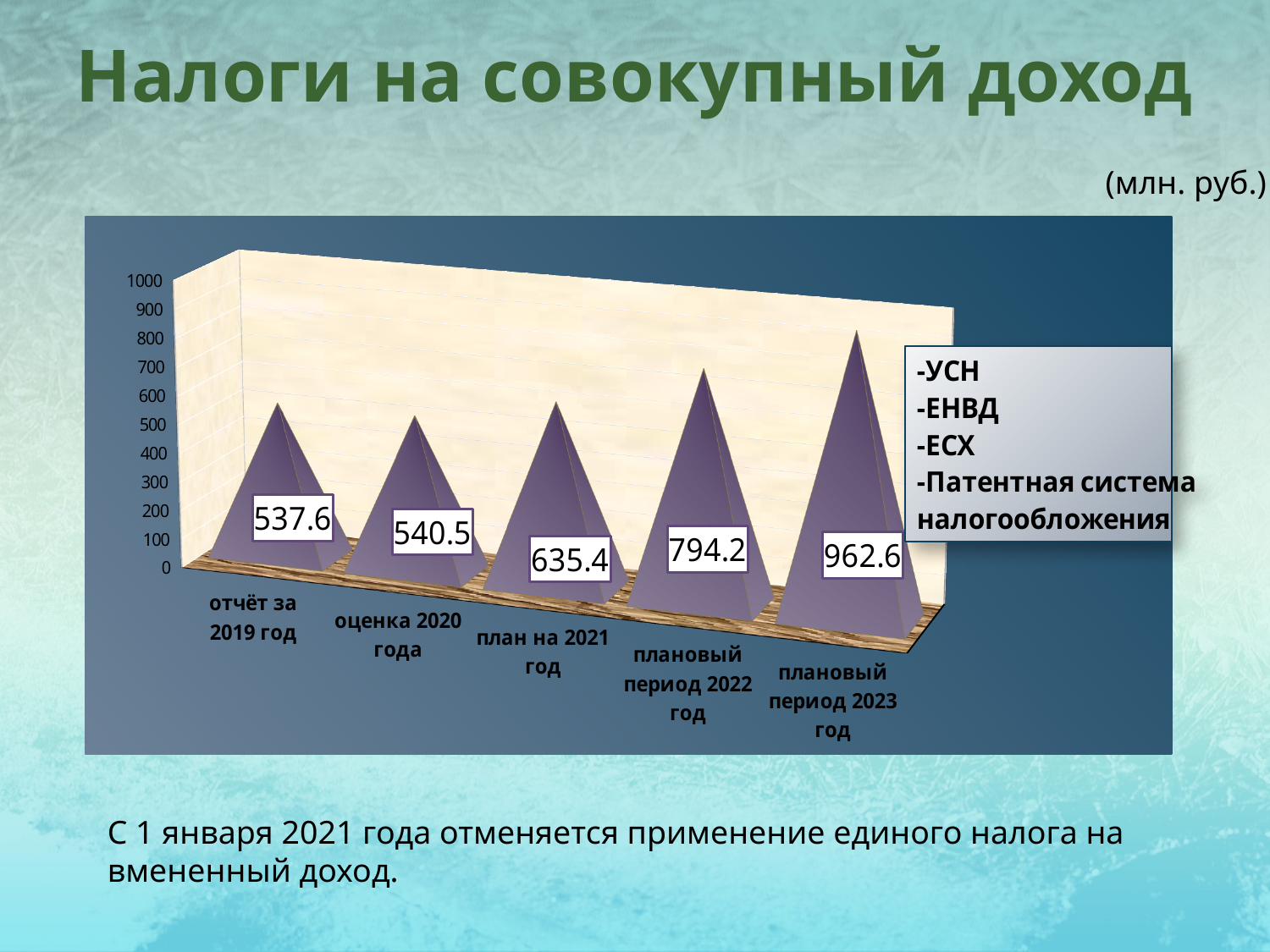
What is the title of the slide containing the chart? Налоги на совокупный доход Which category has the highest value? плановый период 2023 год What is the difference between the values for 'плановый период 2023 год' and 'плановый период 2022 год'? 168.4 Is the value for 'плановый период 2022 год' greater or less than 700? greater What is the value for 'оценка 2020 года'? 540.5 Which category has the lowest value? отчёт за 2019 год How many categories are shown on the x axis? 5 Do the values rise or fall from 'отчёт за 2019 год' to 'плановый период 2023 год'? rise What is the value for 'план на 2021 год'? 635.4 What is the value for 'отчёт за 2019 год'? 537.6 What is the value for 'плановый период 2023 год'? 962.6 Which is larger, the value for 'план на 2021 год' or the value for 'плановый период 2022 год'? плановый период 2022 год